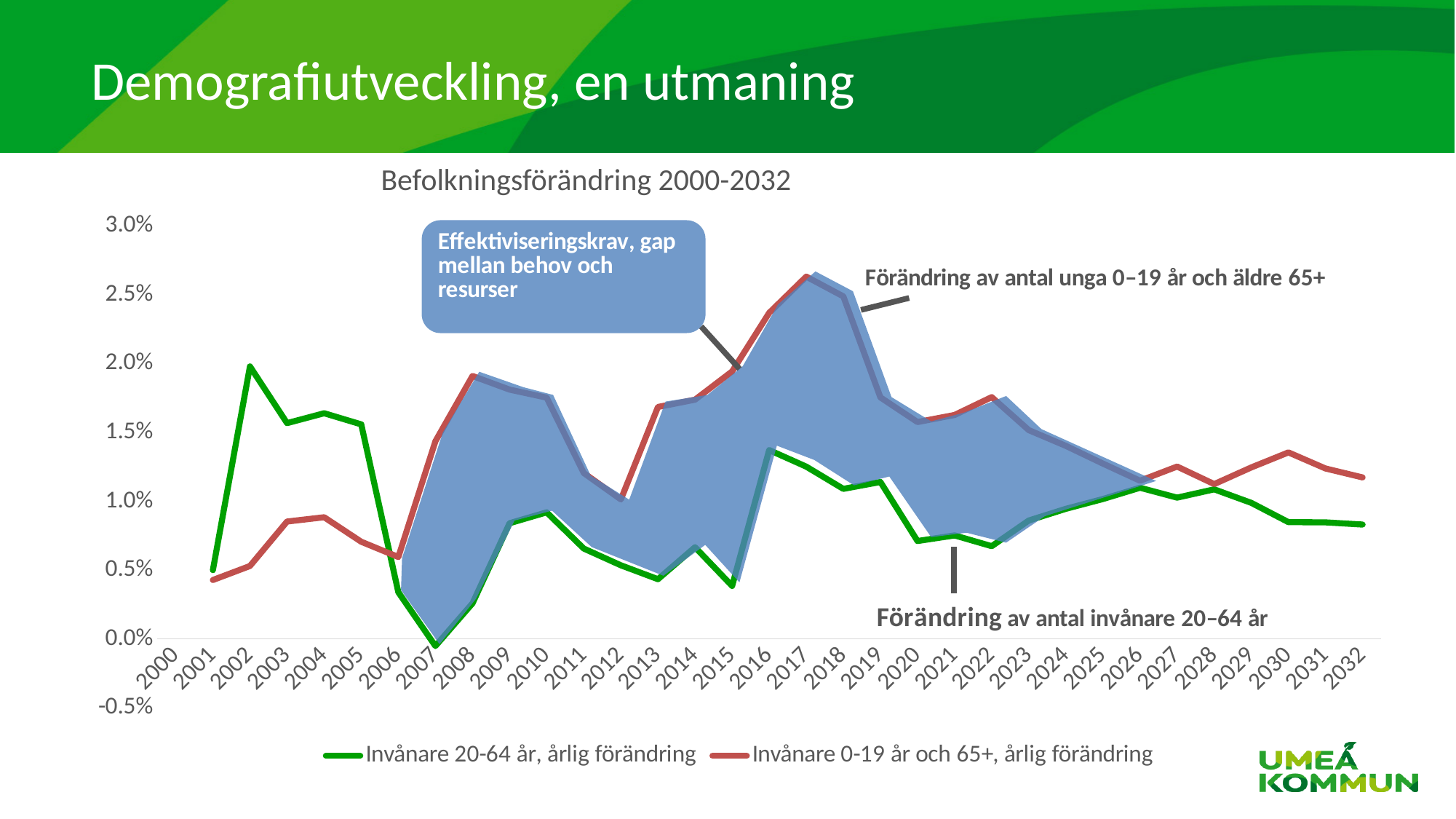
In which year does the series 'Invånare 20-64 år, årlig förändring' reach its lowest value? 2007 Is the value for 'Invånare 20-64 år, årlig förändring' in 2007 greater or less than 0.5%? less In which year does the series 'Invånare 0-19 år och 65+, årlig förändring' reach its highest value? 2017 What kind of chart is shown on the slide? line chart Is the value for 'Invånare 0-19 år och 65+, årlig förändring' in 2017 greater or less than 2.0%? greater In 2017, which series has the larger value: 'Invånare 20-64 år, årlig förändring' or 'Invånare 0-19 år och 65+, årlig förändring'? Invånare 0-19 år och 65+, årlig förändring In 2002, which series has the larger value: 'Invånare 20-64 år, årlig förändring' or 'Invånare 0-19 år och 65+, årlig förändring'? Invånare 20-64 år, årlig förändring What is the title of the chart? Befolkningsförändring 2000-2032 How many series does the legend list? 2 Does the series 'Invånare 20-64 år, årlig förändring' rise or fall from 2026 to 2032? fall In which year does the series 'Invånare 20-64 år, årlig förändring' reach its highest value? 2002 Which colour is used for the series 'Invånare 20-64 år, årlig förändring'? green